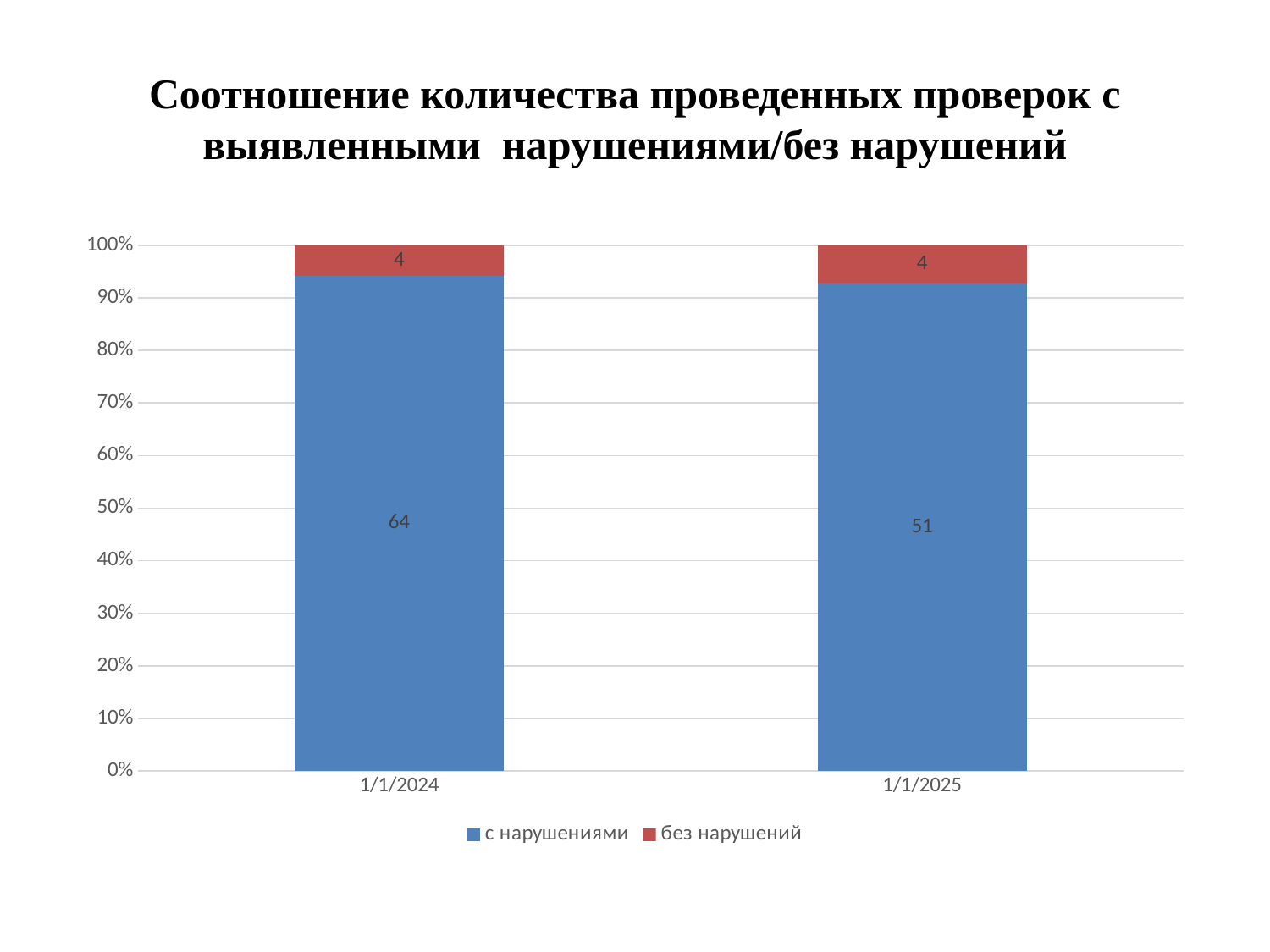
What kind of chart is shown on the slide? Stacked bar chart Is the share of "с нарушениями" on 1/1/2024 greater or less than 90%? greater What is the difference between the "с нарушениями" values for 1/1/2024 and 1/1/2025? 13 What is the value for "с нарушениями" on 1/1/2024? 64 What is the value for "с нарушениями" on 1/1/2025? 51 What is the value for "без нарушений" on 1/1/2024? 4 How many categories are shown on the x axis? 2 What is the total of the stacked bar for 1/1/2025? 55 What is the value for "без нарушений" on 1/1/2025? 4 What is the total of the stacked bar for 1/1/2024? 68 How many series does the legend list? 2 Which date has the higher value for "с нарушениями", 1/1/2024 or 1/1/2025? 1/1/2024